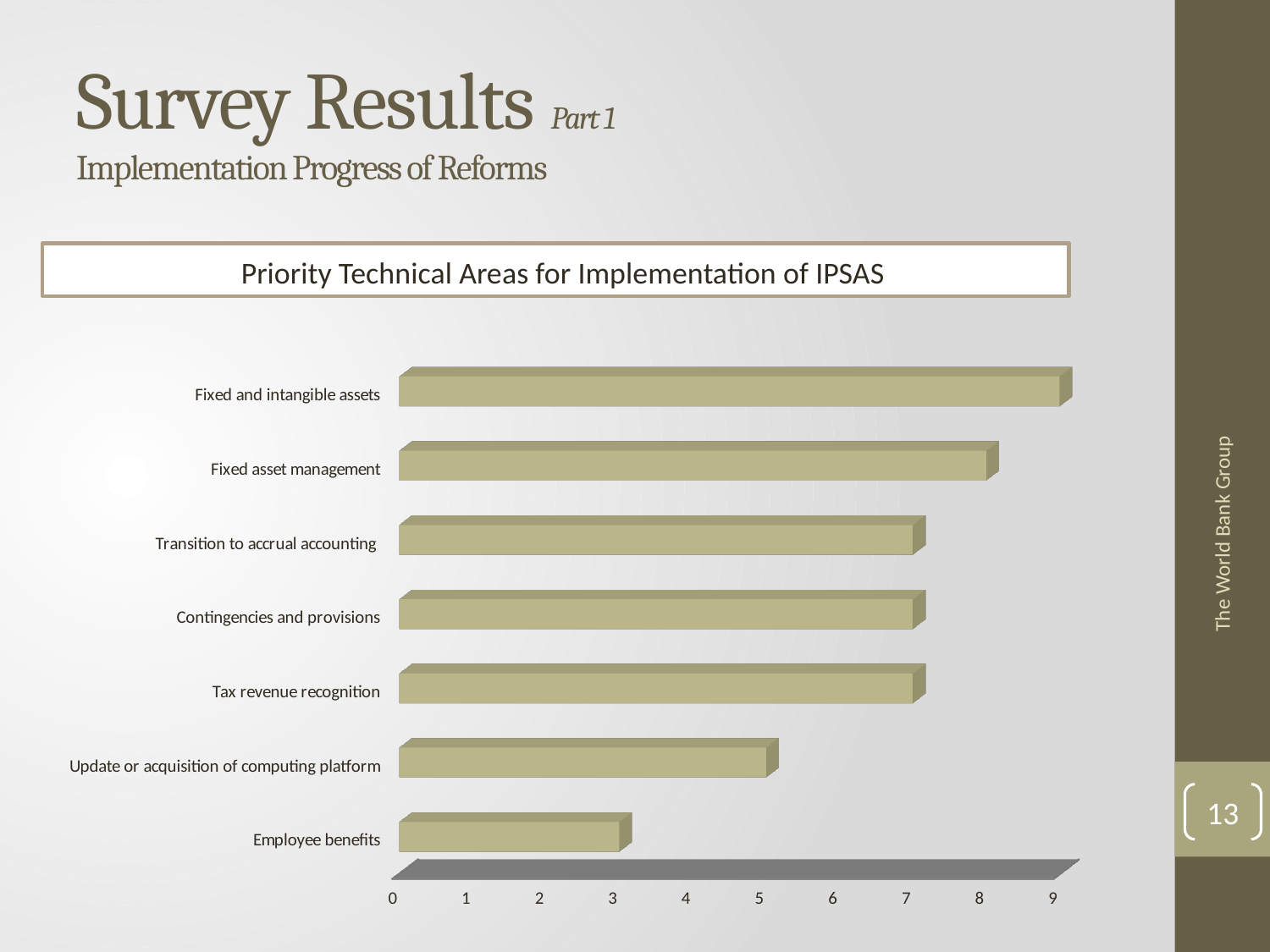
Is the value for Update or acquisition of computing platform greater or less than 4? greater Is the value for Fixed and intangible assets greater or less than 8? greater Is the value for Fixed asset management greater or less than 7? greater What type of chart is shown on the slide? bar chart Which category has the highest value? Fixed and intangible assets Which category has the lowest value? Employee benefits How many categories are plotted in the chart? 7 Which is larger, the value for Fixed asset management or the value for Update or acquisition of computing platform? Fixed asset management Do the bar lengths increase or decrease going from the top category to the bottom category? decrease What is the title of the chart? Priority Technical Areas for Implementation of IPSAS